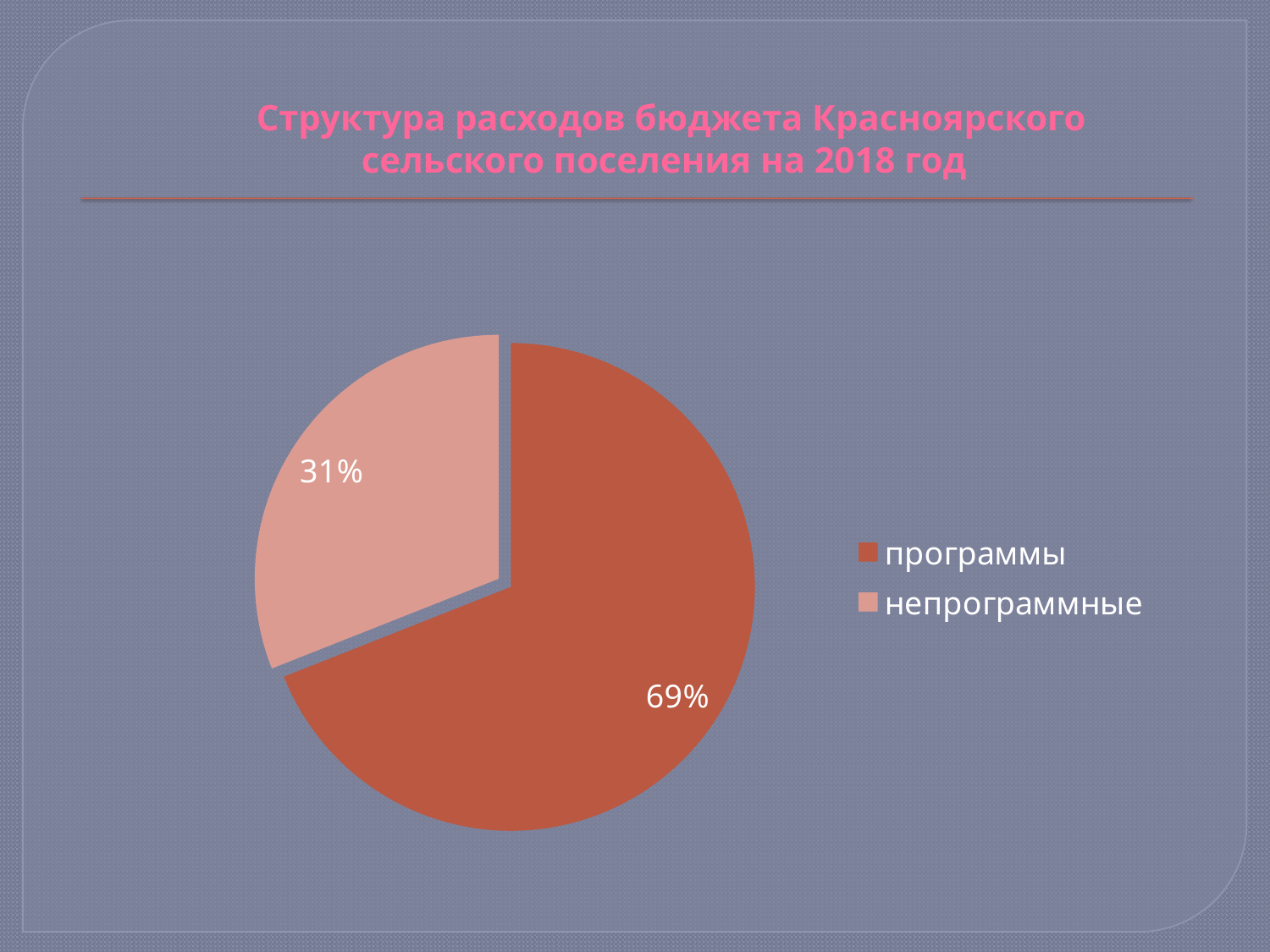
Which category has the largest slice of the pie? программы What share of the pie does the "программы" slice represent? 69% What share of the pie does the "непрограммные" slice represent? 31% What is the title of the chart on the slide? Структура расходов бюджета Красноярского сельского поселения на 2018 год What kind of chart is shown on the slide? pie chart Which slice is larger, "программы" or "непрограммные"? программы Which category has the smallest slice of the pie? непрограммные How many categories are shown in the pie chart? 2 What is the difference in percentage points between the "программы" and "непрограммные" slices? 38 How many entries does the legend list? 2 Which category is shown in the lighter pink colour? непрограммные